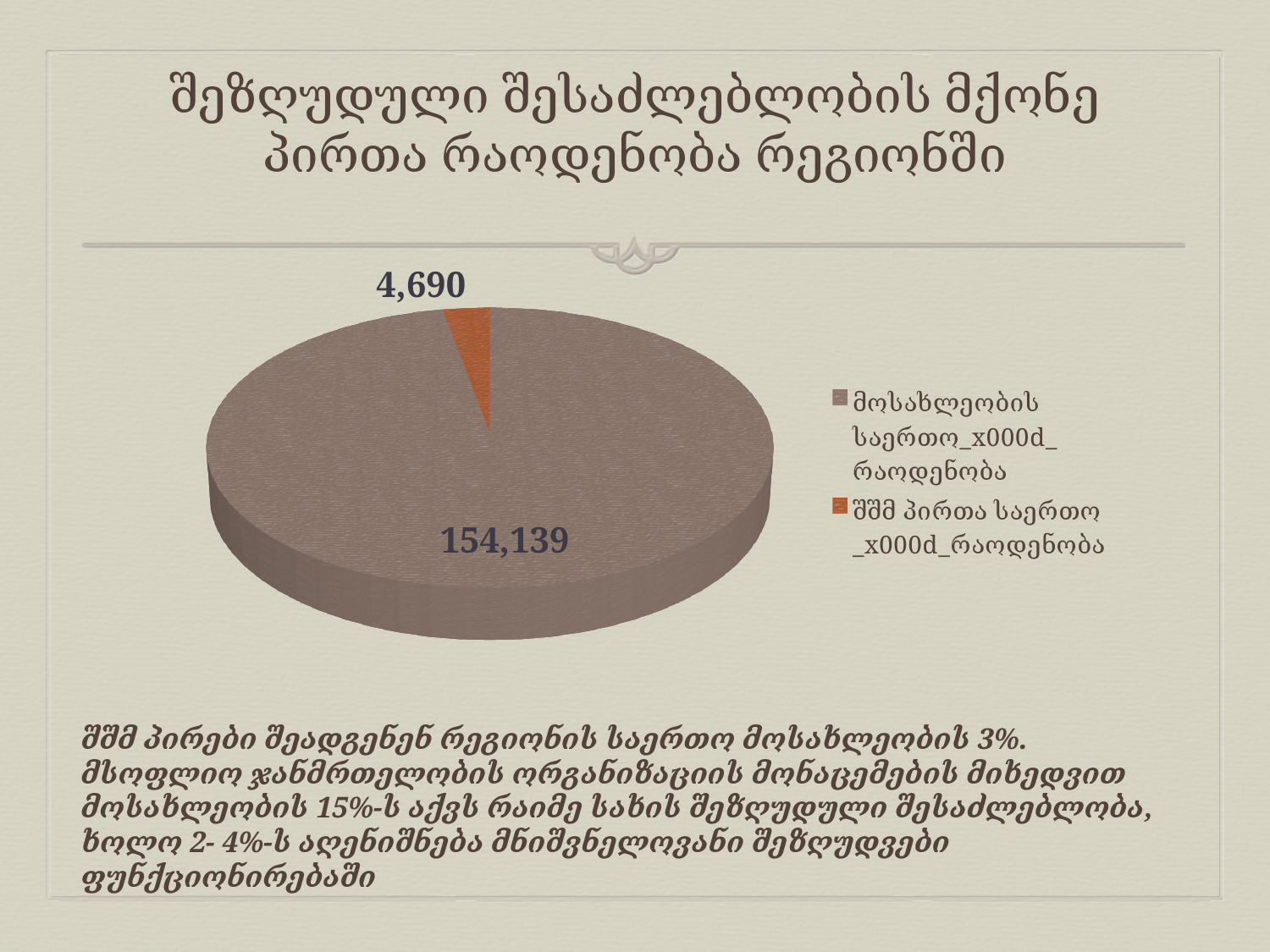
Which slice of the pie chart is the largest? მოსახლეობის საერთო_x000d_ რაოდენობა How many slices does the pie chart have? 2 What is the difference between the two values shown on the pie chart (154,139 and 4,690)? 149,449 What colour is the slice for "შშმ პირთა საერთო _x000d_რაოდენობა"? Orange How many entries does the legend list? 2 What type of chart is shown on the slide? Pie chart What is the total of the two values shown on the pie chart? 158,829 What is the title of the slide containing the pie chart? შეზღუდული შესაძლებლობის მქონე პირთა რაოდენობა რეგიონში Which slice of the pie chart is the smallest? შშმ პირთა საერთო _x000d_რაოდენობა Which is larger: the value for "მოსახლეობის საერთო_x000d_ რაოდენობა" or the value for "შშმ პირთა საერთო _x000d_რაოდენობა"? მოსახლეობის საერთო_x000d_ რაოდენობა What is the value of the slice labelled "მოსახლეობის საერთო_x000d_ რაოდენობა"? 154,139 What is the value of the slice labelled "შშმ პირთა საერთო _x000d_რაოდენობა"? 4,690